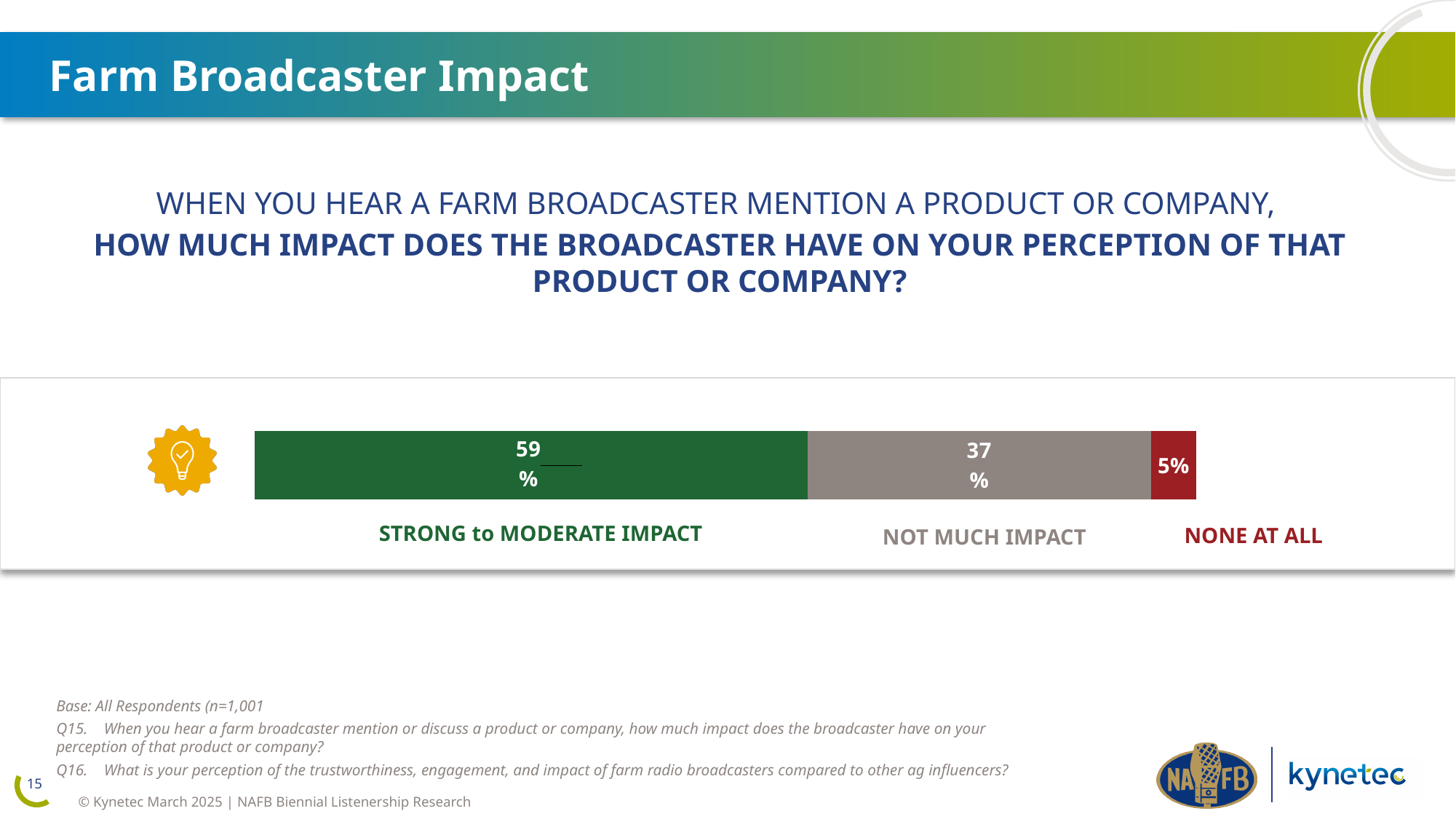
What colour is the segment for 'None at all'? Red How many response categories are shown in the bar? 3 What is the difference in percentage points between 'Strong to moderate impact' and 'Not much impact'? 22 What is the total of the three segments in the stacked bar? 101% What percentage of respondents said a farm broadcaster has no impact at all on their perception? 5% Which is larger: the share for 'Not much impact' or the share for 'None at all'? Not much impact Which response category has the smallest share? None at all What is the difference in percentage points between 'Not much impact' and 'None at all'? 32 What percentage of respondents said a farm broadcaster has a strong to moderate impact on their perception of a product or company? 59% Which response category has the largest share? Strong to moderate impact What kind of chart is used to show the responses? Stacked bar chart What percentage of respondents said a farm broadcaster has not much impact on their perception? 37%